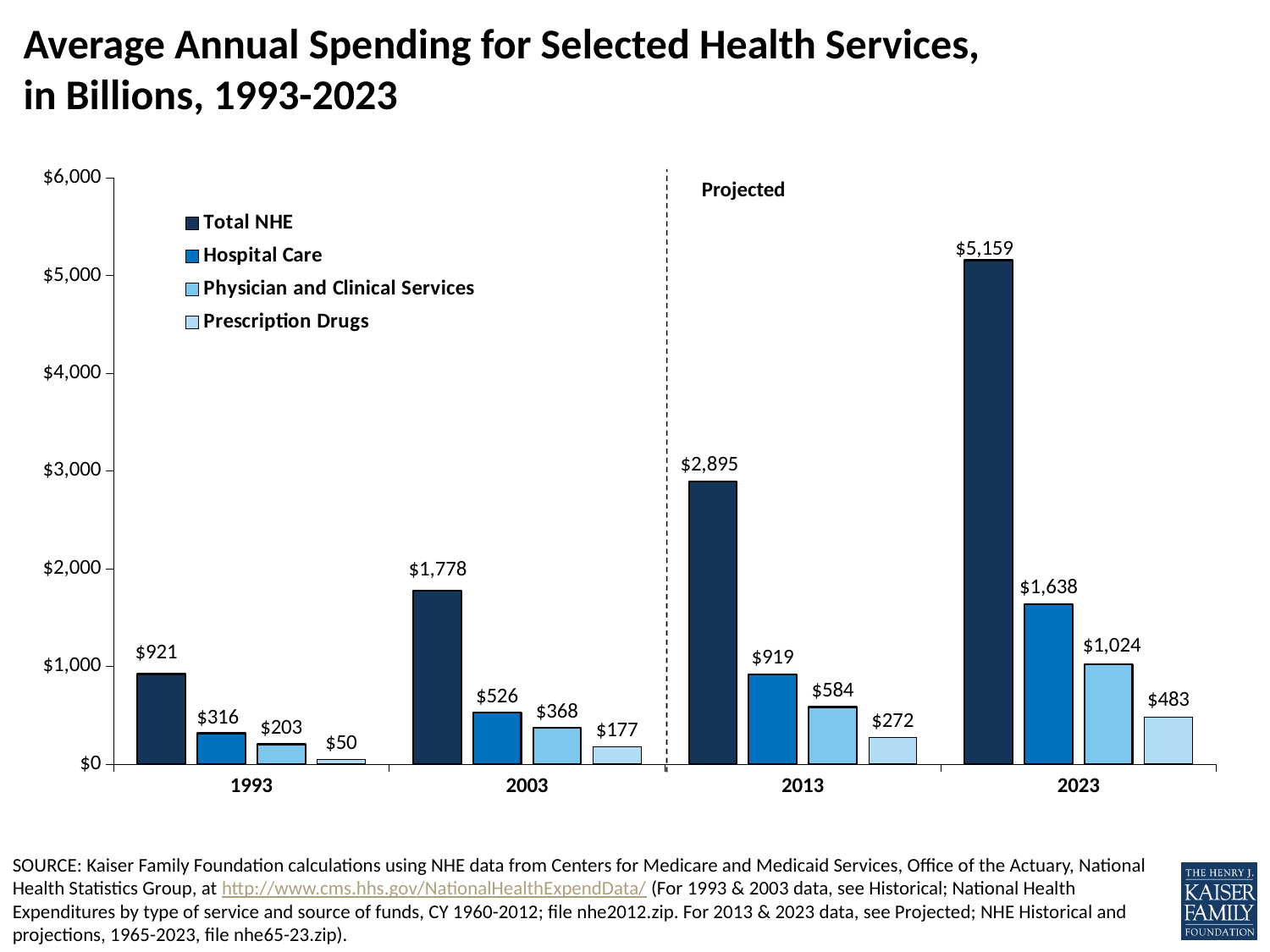
What is the Hospital Care value for 2013? $919 In which year is Prescription Drugs spending lowest? 1993 What kind of chart is shown on the slide? Bar chart What is the Total NHE value for 2023? $5,159 In which year is Total NHE highest? 2023 How many series does the legend list? 4 What is the difference between Total NHE in 2023 and Total NHE in 2013? $2,264 What is the Physician and Clinical Services value for 2003? $368 Which is larger: Hospital Care in 2003 or Physician and Clinical Services in 2013? Physician and Clinical Services in 2013 What is the Prescription Drugs value for 1993? $50 How many years are shown on the x axis? 4 Does Hospital Care spending rise or fall from 1993 to 2023? Rise